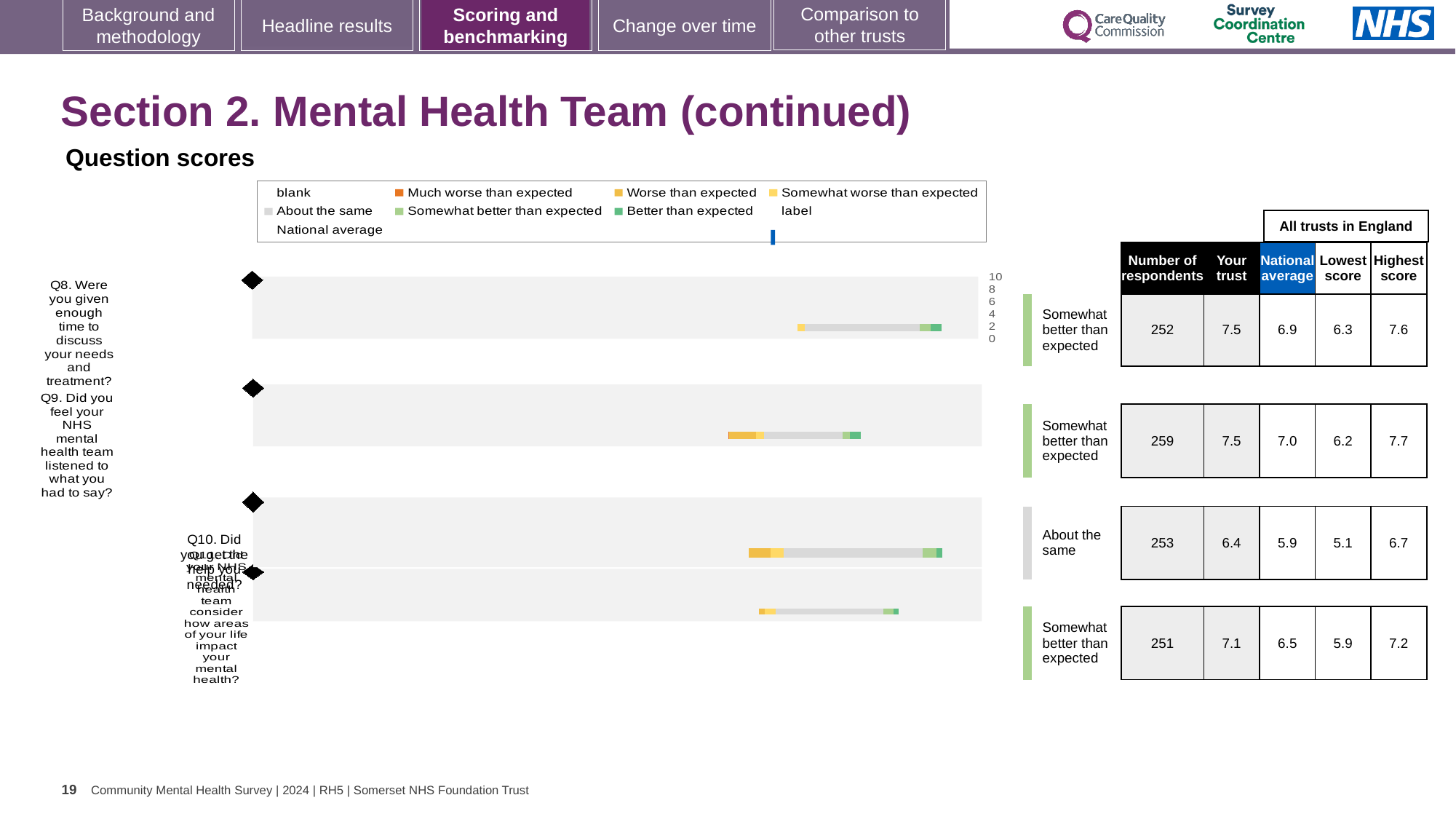
How many respondents answered Q10 (Did you get the help you needed?)? 253 What is the highest score across all trusts in England for Q9? 7.7 What is the difference between the highest score and the lowest score across all trusts in England for Q8? 1.3 By how much does the 'Your trust' score for Q10 exceed the national average for Q10? 0.5 What type of chart is used to show the question scores on this slide? bar chart For Q11, which is larger: the 'Your trust' score or the national average? Your trust How many questions (bars) are plotted in the question scores chart? 4 What does the blue marker in the chart legend represent? National average Which question has the lowest 'Your trust' score? Q10 What is the 'Your trust' score for Q8 (Were you given enough time to discuss your needs and treatment?)? 7.5 What is the national average score for Q9 (Did you feel your NHS mental health team listened to what you had to say?)? 7.0 What benchmark category is shown for Q10? About the same